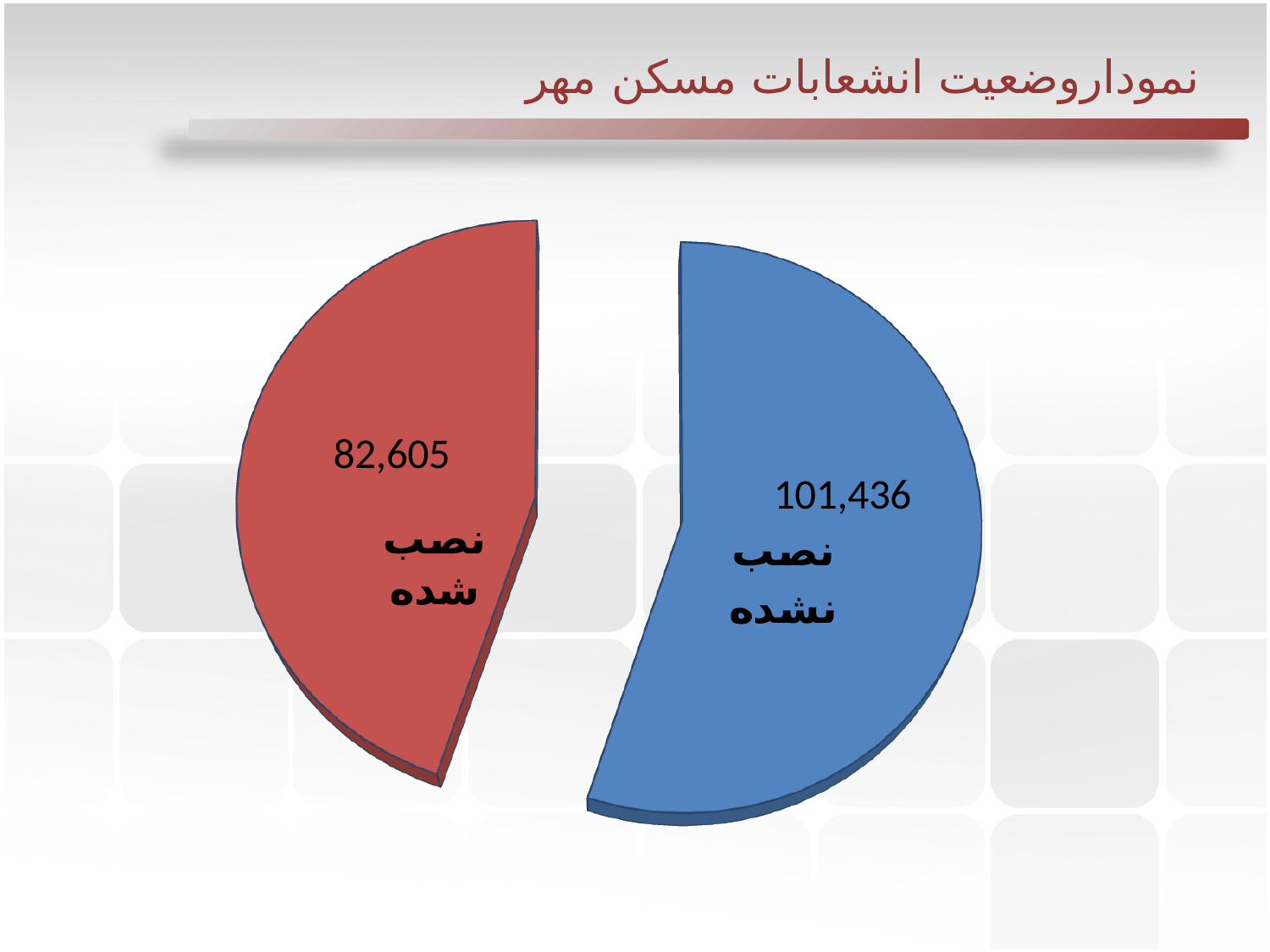
What is the difference between the "نصب نشده" and "نصب شده" values? 18,831 What type of chart is shown on the slide? pie chart What colour is the "نصب شده" slice? red Which slice has the largest value? نصب نشده What is the value for the "نصب شده" slice? 82,605 Which is larger, "نصب شده" or "نصب نشده"? نصب نشده Which slice has the smallest value? نصب شده What is the title of the chart on the slide? نمودار وضعیت انشعابات مسکن مهر What is the total of the two slices in the pie chart? 184,041 What is the value for the "نصب نشده" slice? 101,436 What share of the pie does the "نصب نشده" slice represent, to one decimal place? 55.1% How many slices does the pie chart have? 2